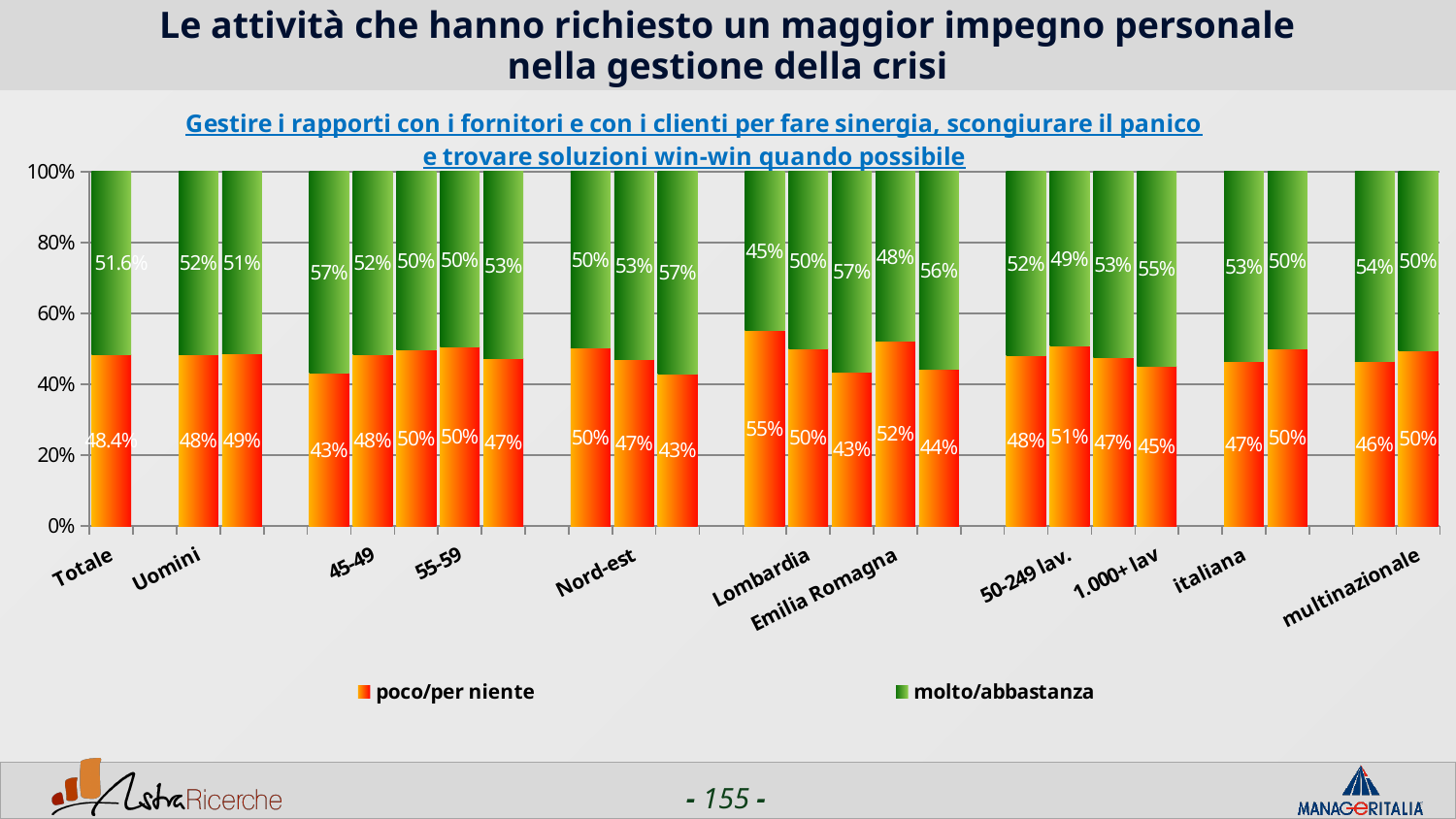
What colour represents the 'molto/abbastanza' series in the legend? Green For 1.000+ lav, what is the difference between the 'molto/abbastanza' and 'poco/per niente' values? 10 percentage points What kind of chart is shown on the slide? Stacked bar chart What is the value of 'poco/per niente' for Totale? 48.4% What is the value of 'molto/abbastanza' for 1.000+ lav? 55% What is the value of 'molto/abbastanza' for 55-59? 50% What is the value of 'poco/per niente' for Nord-est? 47% What is the value of 'molto/abbastanza' for Uomini? 52% How many series does the legend list? 2 Which has the larger 'molto/abbastanza' value, Uomini or 1.000+ lav? 1.000+ lav What is the value of 'poco/per niente' for 50-249 lav.? 51% What is the value of 'molto/abbastanza' for Totale? 51.6%